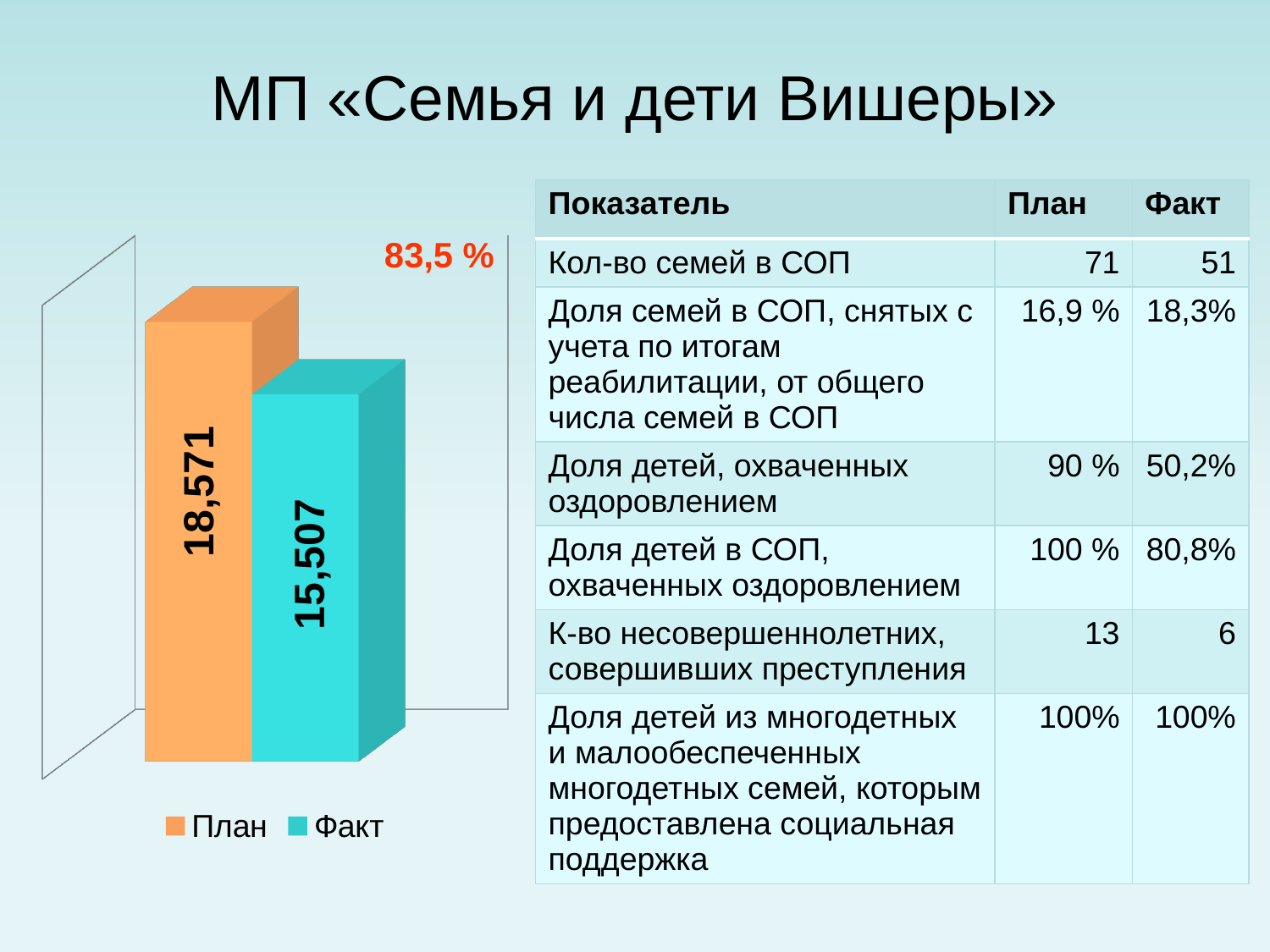
What is the value of the Факт bar in the chart? 15,507 How many series does the chart legend list? 2 How many bars are plotted in the chart? 2 What is the difference between the План and Факт values in the chart? 3,064 What kind of chart is shown on the slide? bar chart What percentage is printed in red above the chart? 83,5 % What is the value of the План bar in the chart? 18,571 What colour is the Факт bar in the chart? teal Which bar in the chart is higher, План or Факт? План Which series has the highest value in the chart? План Which series has the lowest value in the chart? Факт